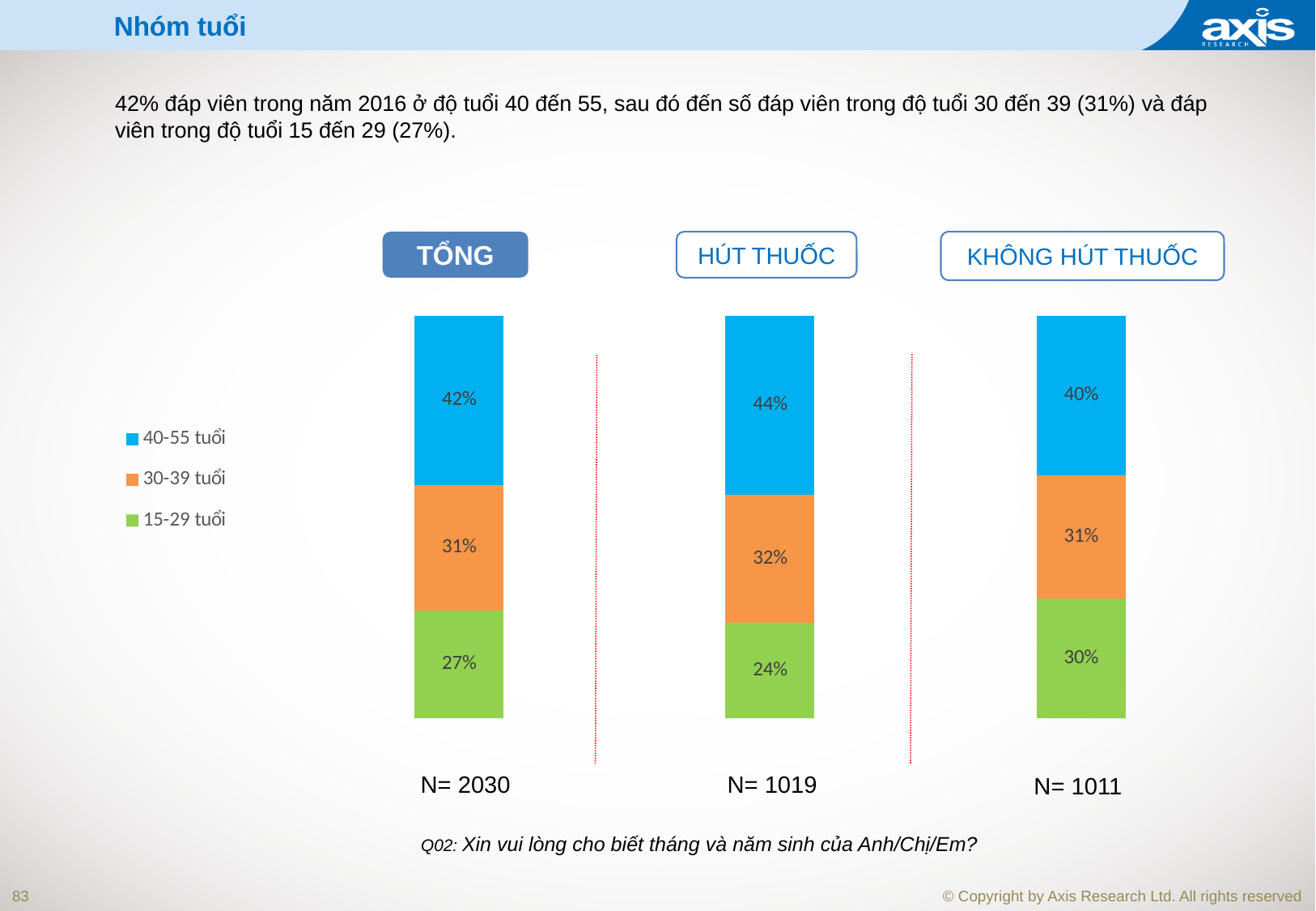
What is the value for 40-55 tuổi in the TỔNG bar? 42% Which group has the highest share of 40-55 tuổi? HÚT THUỐC What is the value for 30-39 tuổi in the KHÔNG HÚT THUỐC bar? 31% Which is larger: the 15-29 tuổi share for TỔNG or for KHÔNG HÚT THUỐC? KHÔNG HÚT THUỐC What is the value for 15-29 tuổi in the HÚT THUỐC bar? 24% What is the difference between the 40-55 tuổi share for HÚT THUỐC and for KHÔNG HÚT THUỐC? 4 percentage points What is the sample size (N) shown under the HÚT THUỐC bar? N= 1019 Which group has the lowest share of 15-29 tuổi? HÚT THUỐC What is the total of the TỔNG stacked bar? 100% How many series does the legend list? 3 How many stacked bars are shown on the slide? 3 What kind of chart is shown on the slide? Stacked bar chart